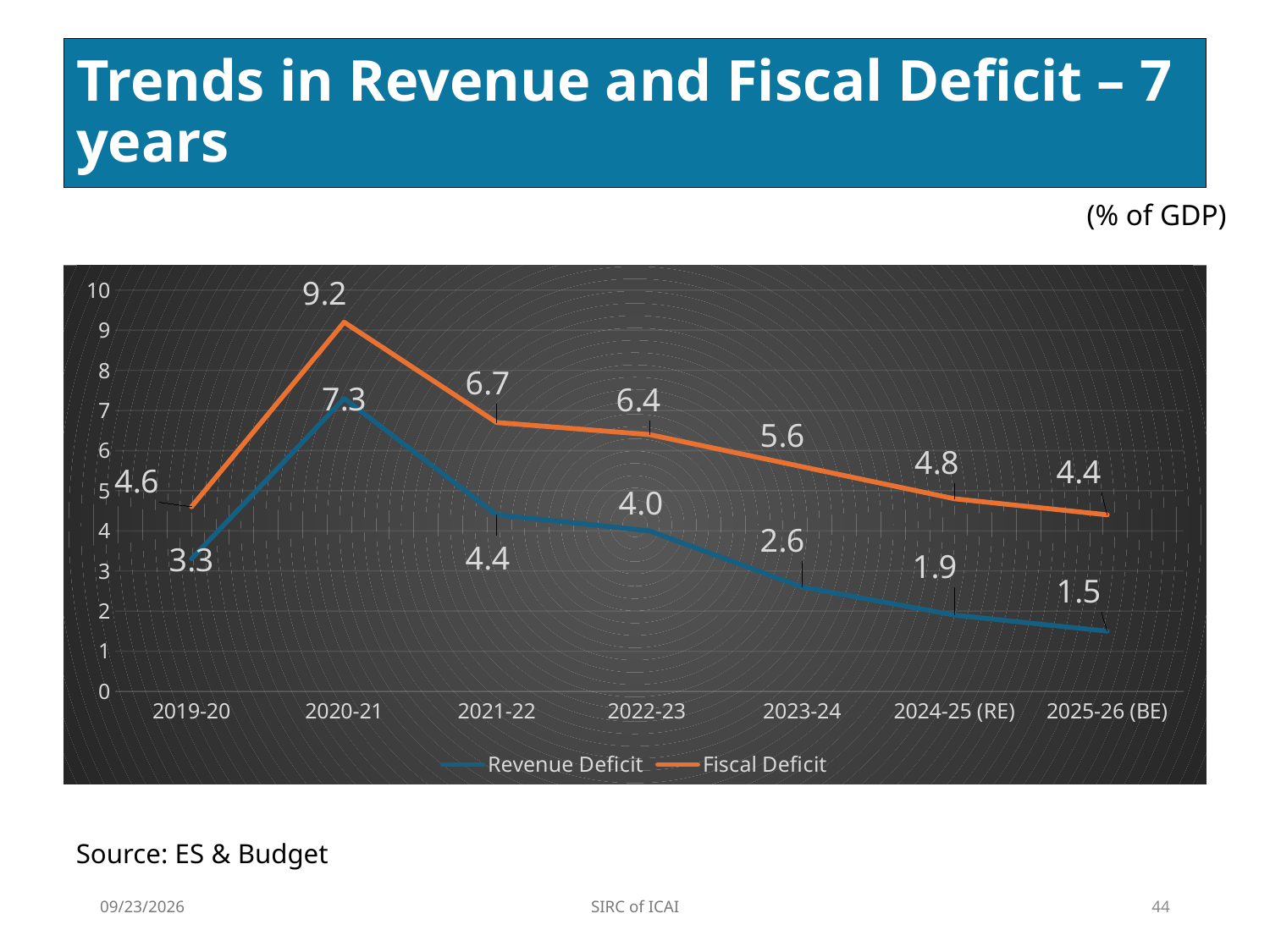
What is the Fiscal Deficit value for 2020-21? 9.2 How many years (categories) are plotted on the x axis? 7 What is the difference between the Fiscal Deficit and the Revenue Deficit in 2023-24? 3.0 In which year is the Fiscal Deficit highest? 2020-21 What unit is indicated for the values in the chart? % of GDP What type of chart is shown on the slide? Line chart Which is larger, the Fiscal Deficit in 2019-20 or the Fiscal Deficit in 2025-26 (BE)? 2019-20 What is the Revenue Deficit value for 2022-23? 4.0 In which year is the Revenue Deficit lowest? 2025-26 (BE) From 2020-21 to 2025-26 (BE), does the Revenue Deficit rise or fall? Fall How many series does the legend list? 2 What is the Revenue Deficit value for 2025-26 (BE)? 1.5